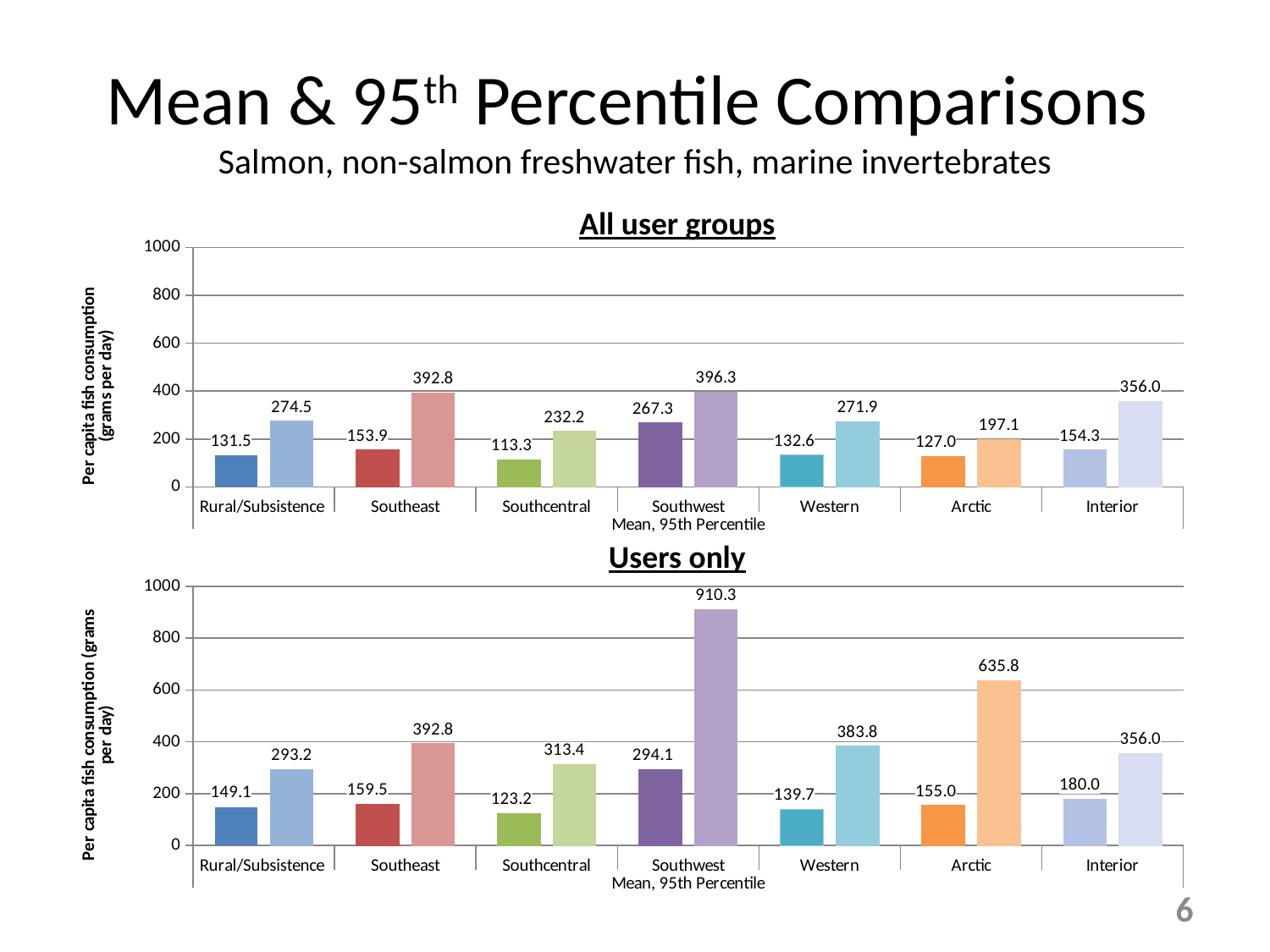
In the 'Users only' chart, is the 95th percentile value for Southwest greater or less than 800? greater In the 'Users only' chart, what is the difference between the 95th percentile and mean values for Southwest? 616.2 In the 'All user groups' chart, what is the 95th percentile value for Interior? 356.0 In the 'All user groups' chart, what is the mean value for Southwest? 267.3 In the 'All user groups' chart, which is larger: the 95th percentile for Southeast or the 95th percentile for Western? Southeast How many regions are shown on the x axis of the 'All user groups' chart? 7 What kind of chart is the 'Users only' chart? bar chart What is the y-axis label of the 'All user groups' chart? Per capita fish consumption (grams per day) In the 'Users only' chart, which region has the highest 95th percentile value? Southwest In the 'Users only' chart, what is the difference between the mean values for Interior and Southcentral? 56.8 In the 'All user groups' chart, which region has the lowest mean value? Southcentral In the 'Users only' chart, what is the 95th percentile value for Arctic? 635.8